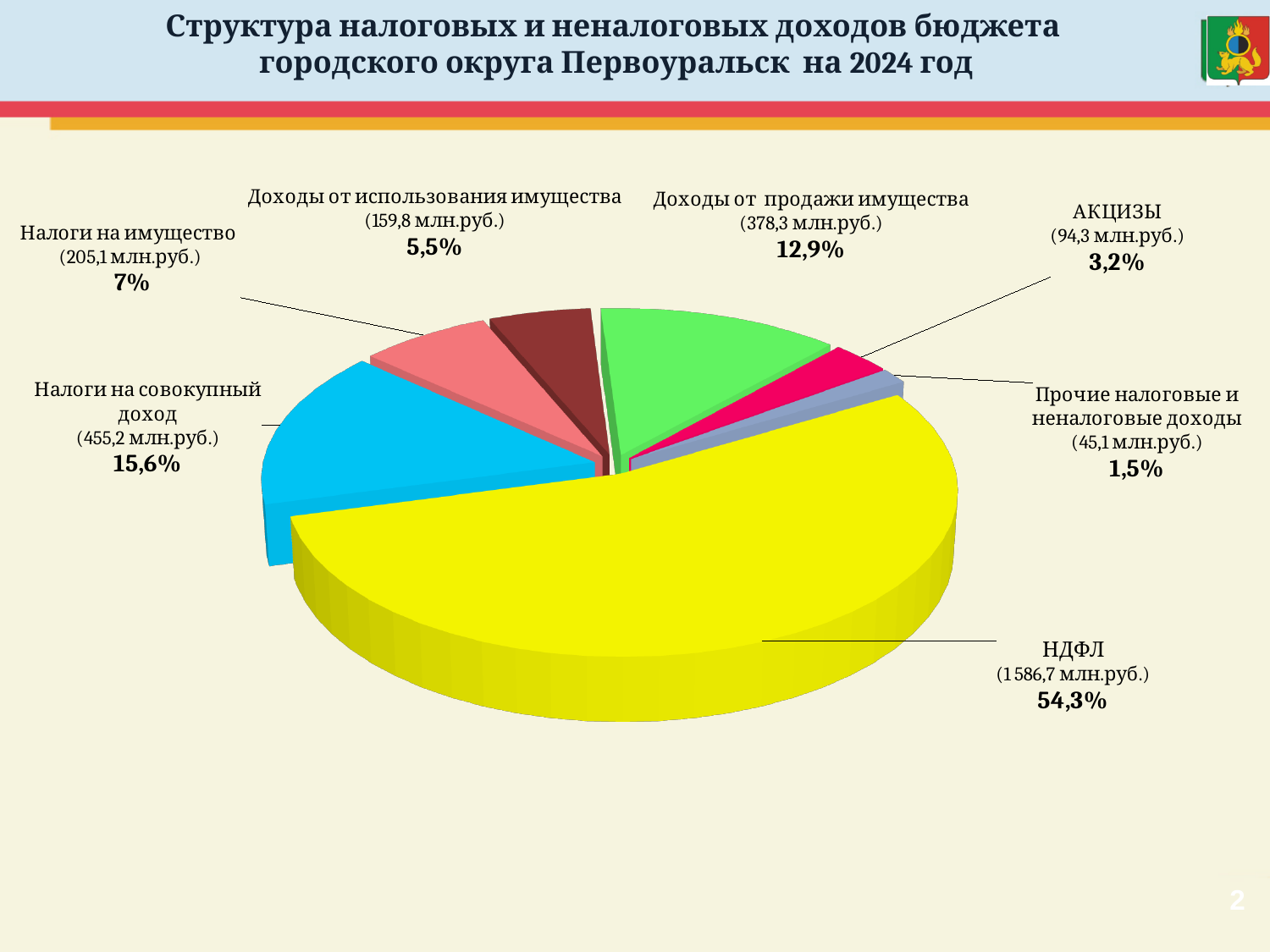
Каким цветом на диаграмме показан сектор НДФЛ? Жёлтым Какую долю составляет НДФЛ в структуре доходов? 54,3% Какая категория имеет наибольшую долю в структуре доходов? НДФЛ Какая категория имеет наименьшую долю в структуре доходов? Прочие налоговые и неналоговые доходы Какой тип диаграммы показан на слайде? Круговая диаграмма Сколько категорий доходов показано на диаграмме? 7 Какова сумма прочих налоговых и неналоговых доходов? 45,1 млн.руб. Какую долю составляют акцизы? 3,2% На сколько процентных пунктов доля налогов на совокупный доход больше доли доходов от продажи имущества? 2,7 Какова сумма доходов от продажи имущества (млн.руб.)? 378,3 млн.руб. Какова сумма налогов на совокупный доход? 455,2 млн.руб. Что больше: доля налогов на имущество или доля доходов от использования имущества? Налоги на имущество